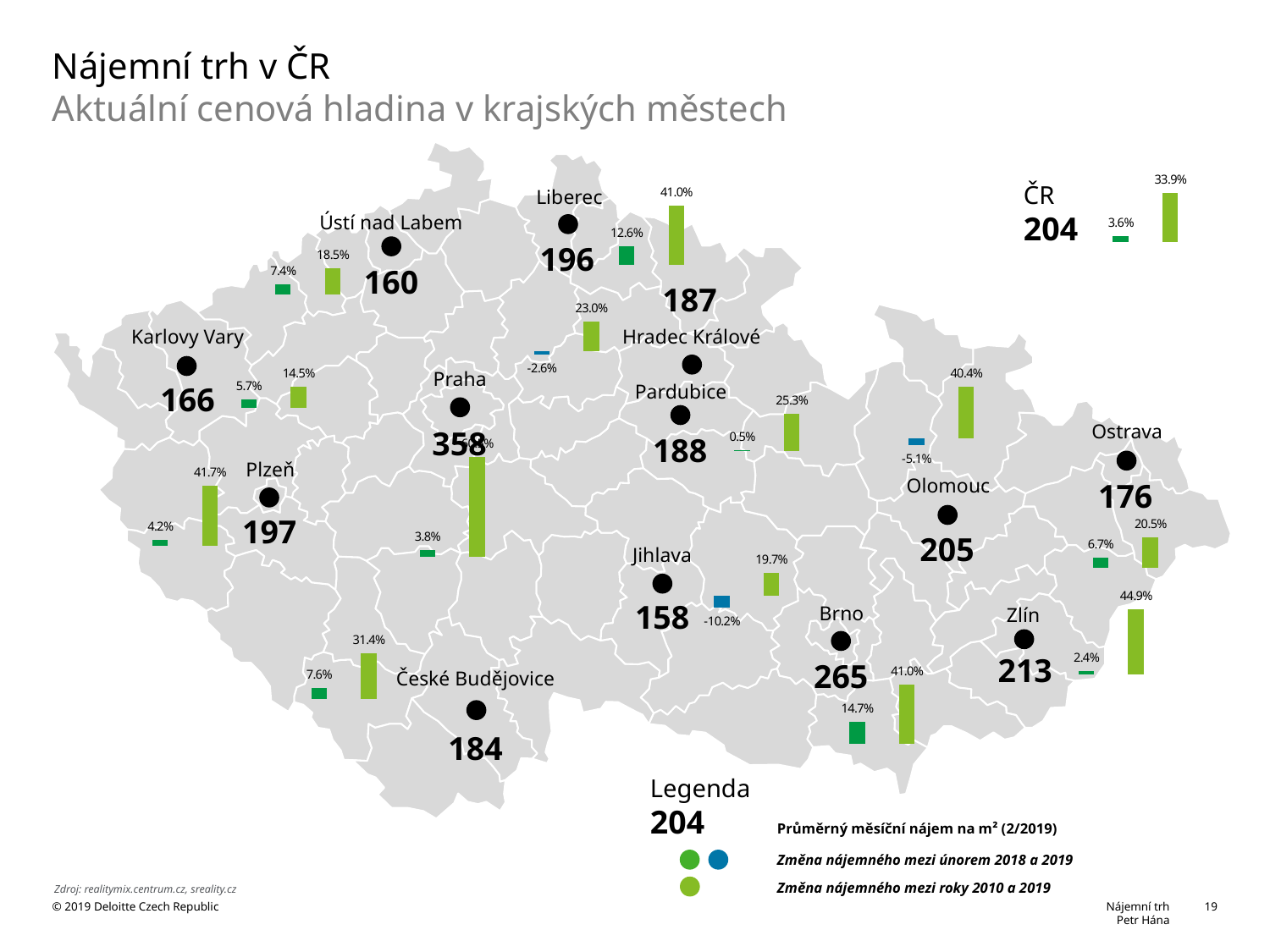
According to the legend, what does the blue bar colour indicate? Změna nájemného mezi únorem 2018 a 2019 What is the change in rent between February 2018 and 2019 shown for Jihlava? -10.2% What is the average monthly rent per m² shown for Brno? 265 What is the change in rent between 2010 and 2019 shown for Olomouc? 40.4% Which regional city has the lowest average monthly rent per m²? Jihlava How many regional cities are shown on the map with rent values? 13 What is the average monthly rent per m² shown for Praha? 358 What is the average monthly rent per m² shown for the whole ČR? 204 Which has a higher average monthly rent per m², Ostrava or Olomouc? Olomouc Which regional city has the highest average monthly rent per m²? Praha What is the change in rent between 2010 and 2019 shown for Zlín? 44.9% What is the difference between the average monthly rent per m² in Praha and in Brno? 93